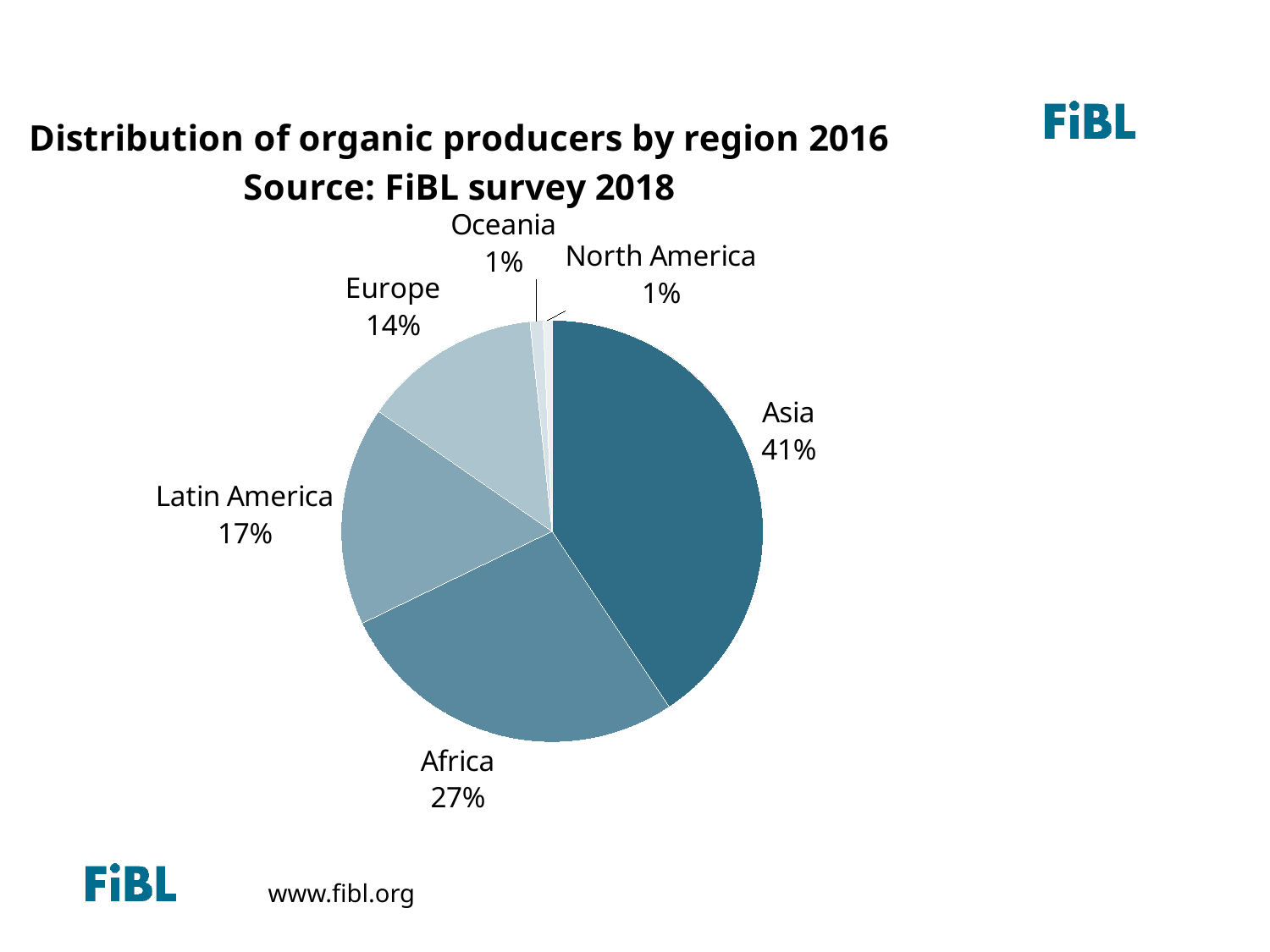
How many regions are shown in the pie chart? 6 What is the difference between the shares of Latin America and Europe? 3% Which region has the largest share of organic producers? Asia What share of organic producers is in Africa? 27% What share of organic producers is in Latin America? 17% Which region has a larger share, Africa or Latin America? Africa What is the title of the chart? Distribution of organic producers by region 2016 What share of organic producers is in Europe? 14% What is the difference between the shares of Asia and Africa? 14% What kind of chart is shown on the slide? Pie chart What share of organic producers is in Asia? 41% Which region has a larger share, Europe or Asia? Asia